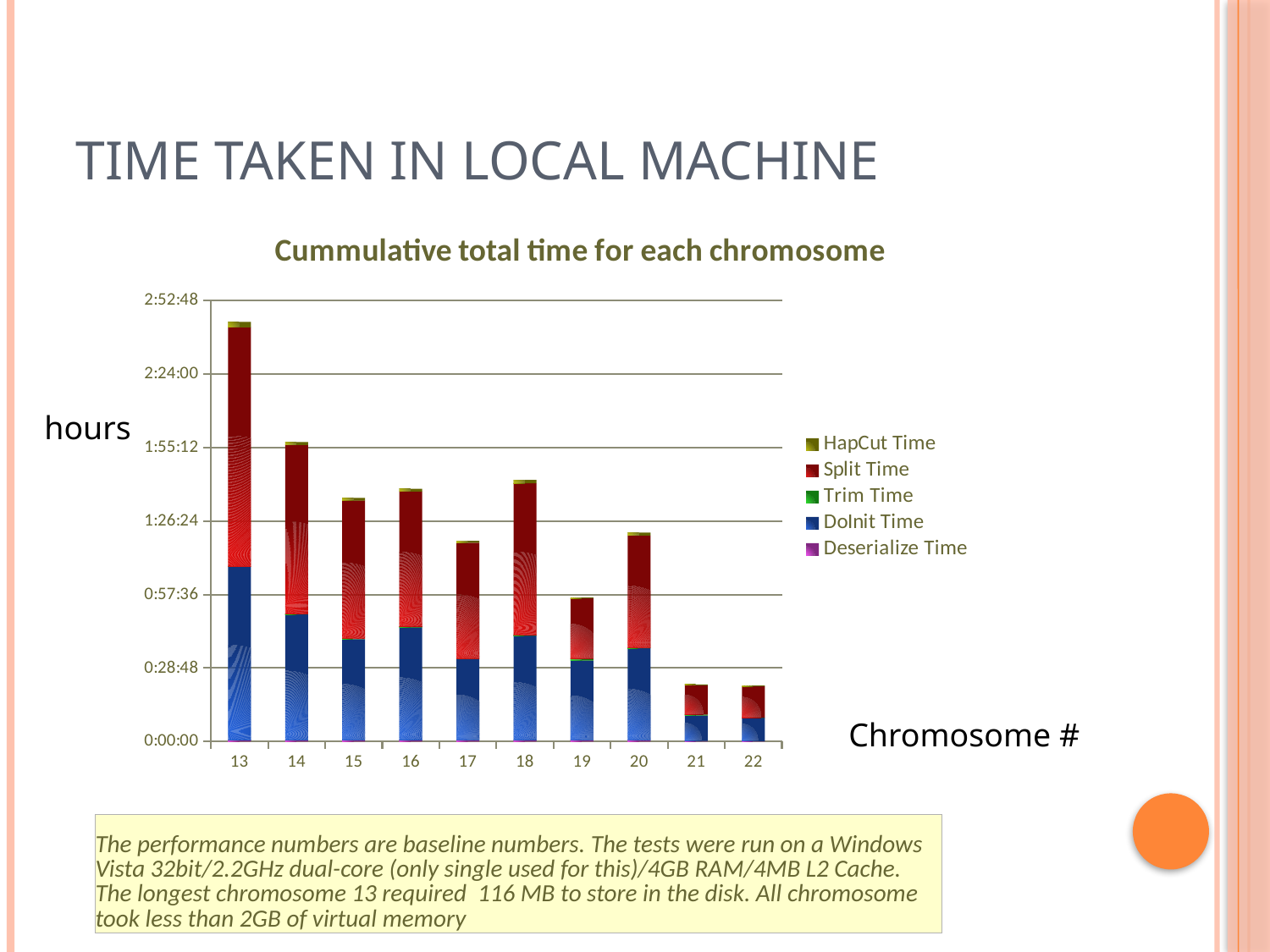
Is the total time for chromosome 13 greater or less than 2:24:00? greater What is the title of the chart? Cummulative total time for each chromosome Which has a larger total time, chromosome 13 or chromosome 14? 13 Which series is shown in dark red in the legend? Split Time Which chromosome has the highest cumulative total time? 13 Is the total time for chromosome 20 greater or less than 1:26:24? less Is the total time for chromosome 18 greater or less than 1:26:24? greater Which has a larger total time, chromosome 17 or chromosome 18? 18 What kind of chart is shown on the slide? stacked bar chart How many series does the legend list? 5 How many chromosomes are plotted on the x axis? 10